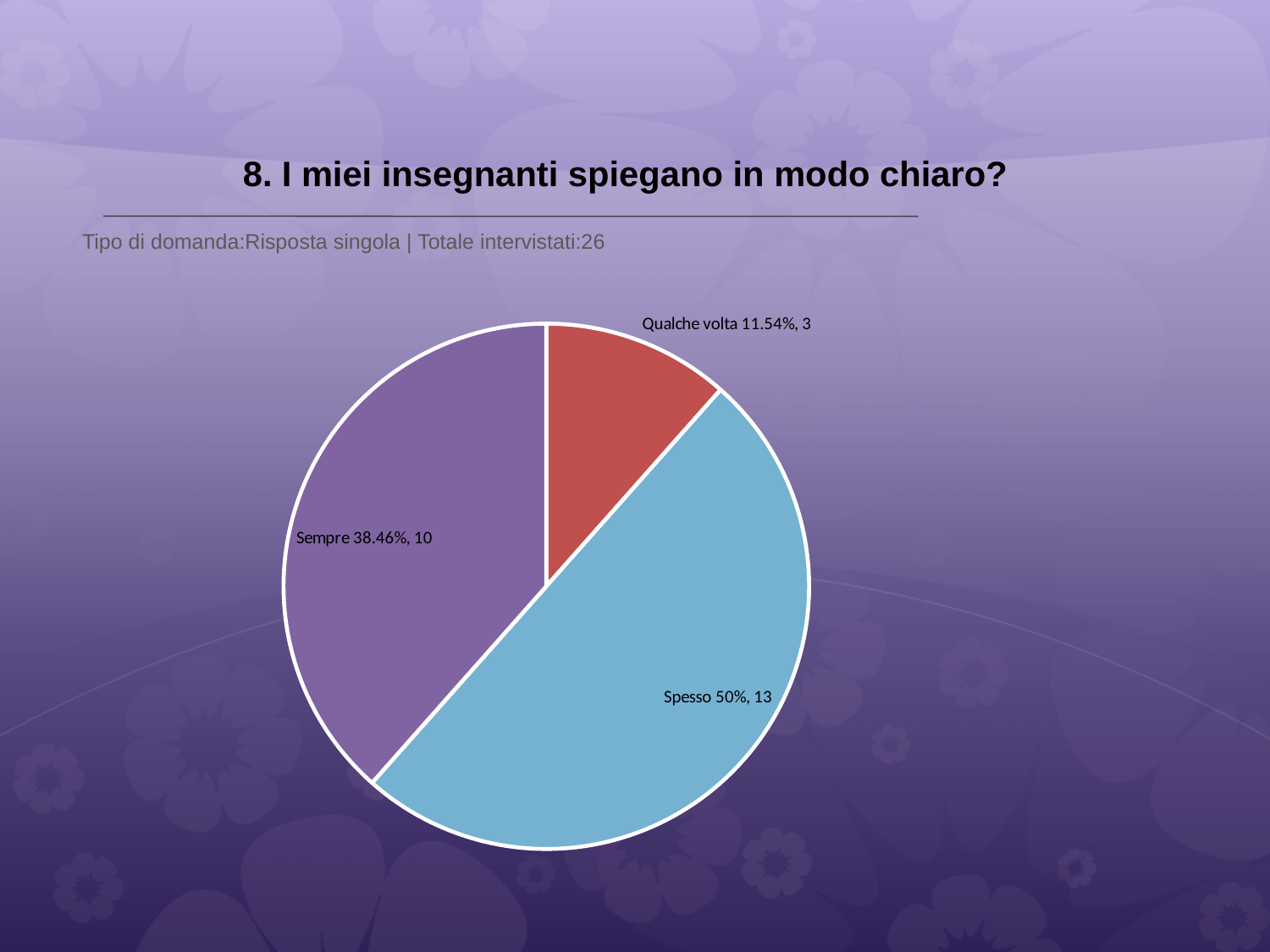
Which category has the smallest slice? Qualche volta What share of the pie does the 'Qualche volta' slice represent? 11.54% How many respondents answered 'Qualche volta'? 3 How many respondents answered 'Sempre'? 10 What share of the pie does the 'Spesso' slice represent? 50% What share of the pie does the 'Sempre' slice represent? 38.46% What is the difference in respondent count between 'Spesso' and 'Sempre'? 3 Which category has the largest slice? Spesso How many respondents answered 'Spesso'? 13 What kind of chart is shown on the slide? pie chart Which is larger, the 'Sempre' slice or the 'Qualche volta' slice? Sempre How many slices does the pie chart have? 3